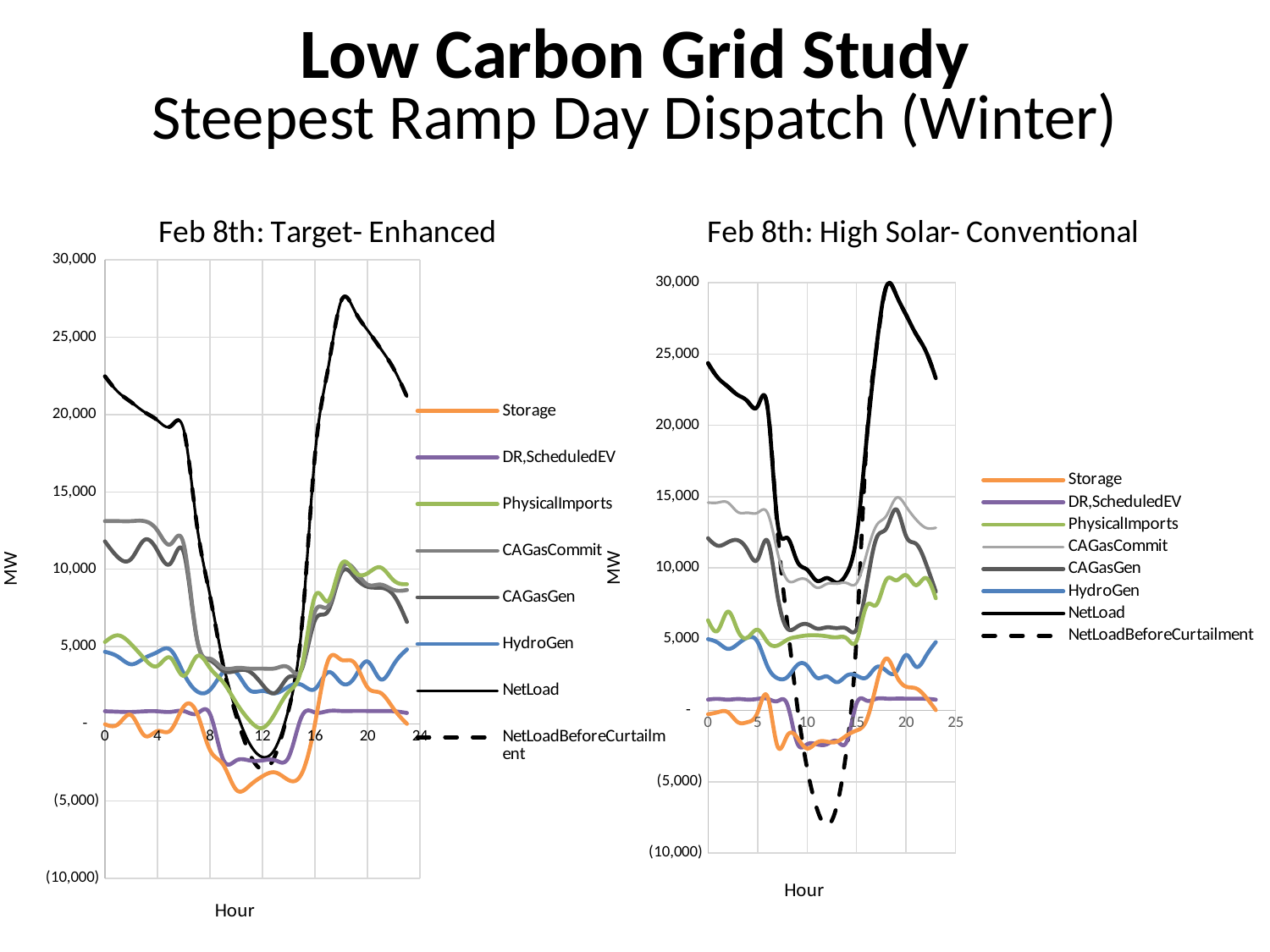
In the 'Feb 8th: Target- Enhanced' chart, is the peak value of NetLoad greater or less than 25,000? greater In the 'Feb 8th: High Solar- Conventional' chart, is the lowest value of NetLoadBeforeCurtailment greater or less than (5,000)? less What kind of chart is the 'Feb 8th: Target- Enhanced' chart? line chart In the 'Feb 8th: Target- Enhanced' chart, which series reaches the lowest value? Storage How many series does the legend of the 'Feb 8th: High Solar- Conventional' chart list? 8 In the 'Feb 8th: Target- Enhanced' chart, does NetLoad rise or fall between hour 12 and hour 18? rise In the 'Feb 8th: High Solar- Conventional' chart, does NetLoad rise or fall between hour 0 and hour 10? fall In the 'Feb 8th: High Solar- Conventional' chart, at hour 0, which is larger: NetLoad or CAGasCommit? NetLoad What is the x-axis title of the 'Feb 8th: Target- Enhanced' chart? Hour In the 'Feb 8th: High Solar- Conventional' chart, which series reaches the lowest value? NetLoadBeforeCurtailment In the 'Feb 8th: Target- Enhanced' chart, which series reaches the highest value? NetLoad In the 'Feb 8th: Target- Enhanced' chart, is the value of CAGasCommit at hour 0 greater or less than 10,000? greater